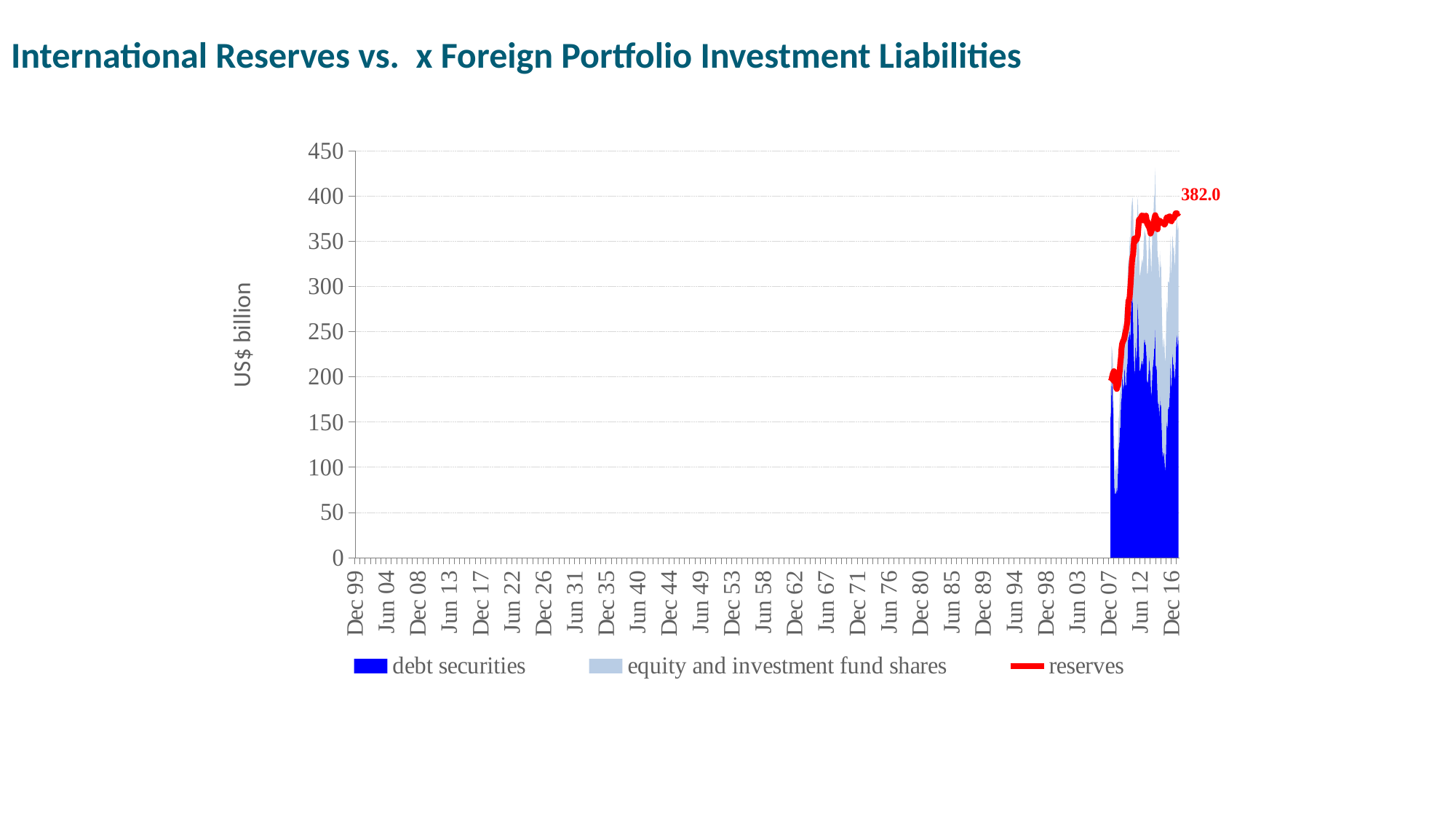
What is the highest value shown on the vertical axis? 450 Is the final value of the reserves series greater or less than 350? greater Do the reserves rise or fall overall from the start of the plotted data to the end? rise Which series is shown in dark blue? debt securities What is the value printed at the end of the reserves line? 382.0 What colour is the reserves line? red Is the value of reserves at the start of the plotted data (around Dec 07) greater or less than 250? less What is the label on the vertical axis? US$ billion How many series does the legend list? 3 What kind of chart is used to plot the reserves series? line chart